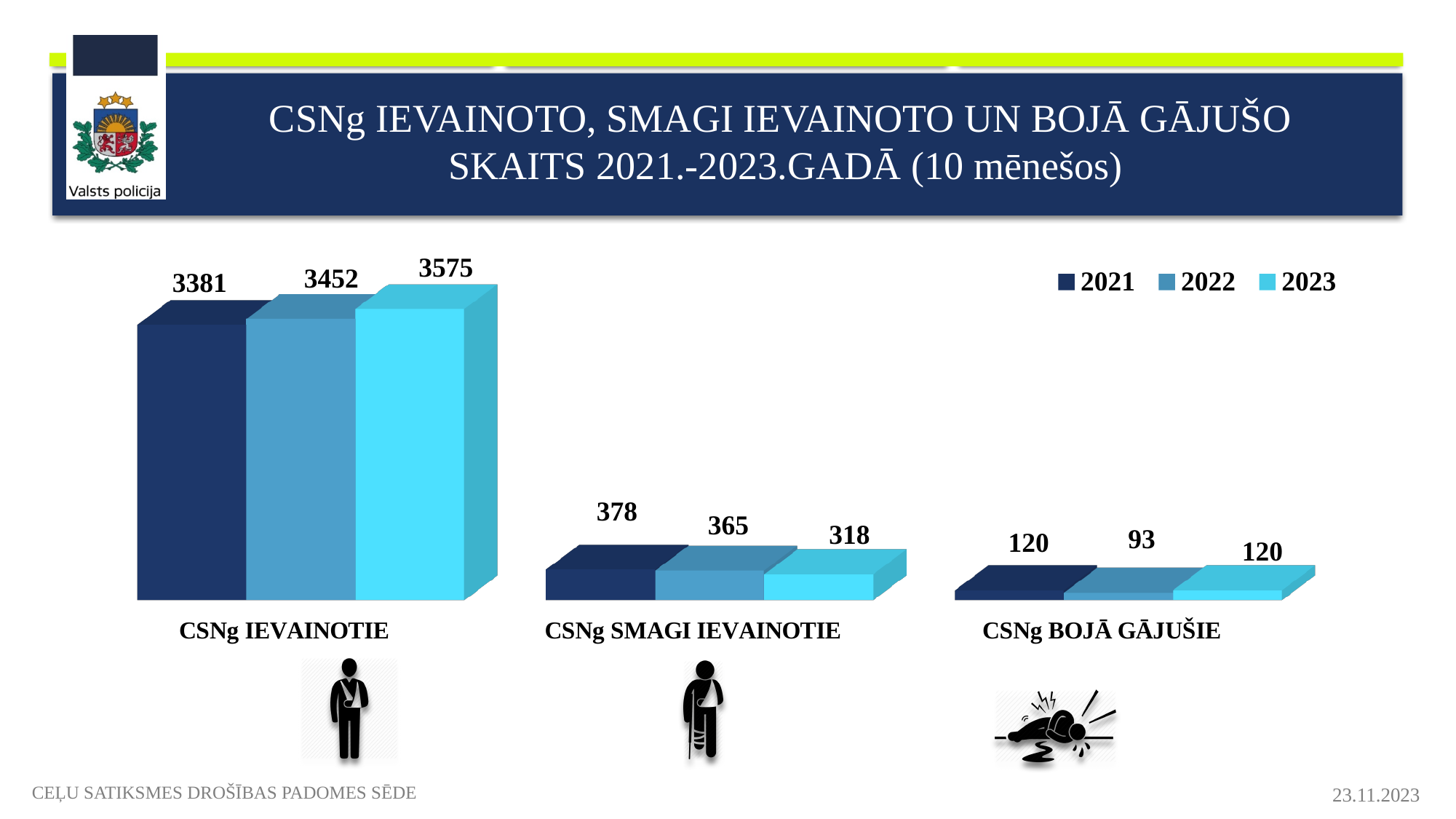
How many categories are shown on the x axis of the chart? 3 Which is larger in the CSNg BOJĀ GĀJUŠIE category: the 2021 value or the 2022 value? 2021 What is the value for 2022 in the CSNg BOJĀ GĀJUŠIE category? 93 What is the difference between the 2021 and 2023 values in the CSNg SMAGI IEVAINOTIE category? 60 What is the difference between the 2023 and 2021 values in the CSNg IEVAINOTIE category? 194 What is the value for 2022 in the CSNg SMAGI IEVAINOTIE category? 365 How many series does the legend list? 3 Do the values in the CSNg SMAGI IEVAINOTIE category rise or fall from 2021 to 2023? fall What kind of chart is shown on the slide? bar chart Which year has the highest value in the CSNg IEVAINOTIE category? 2023 Which year has the lowest value in the CSNg SMAGI IEVAINOTIE category? 2023 What is the value for 2023 in the CSNg IEVAINOTIE category? 3575